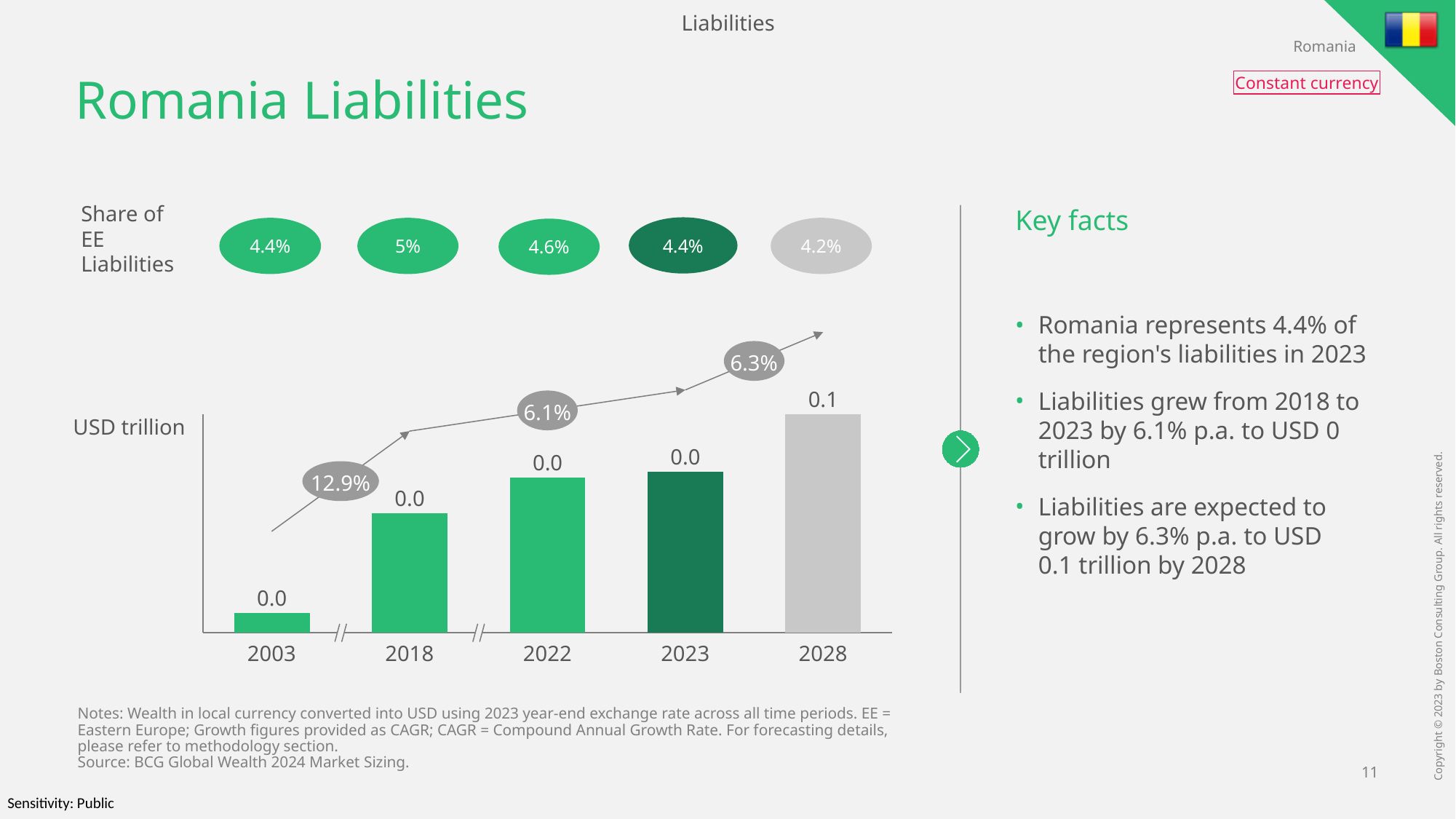
Which bar is taller, 2018 or 2022? 2022 How many years are shown on the x axis of the bar chart? 5 What is the data label on the bar for 2023? 0.0 Which year has the tallest bar in the chart? 2028 What growth rate (CAGR) is shown between 2023 and 2028? 6.3% Do the bar values rise or fall from 2003 to 2028? rise Which year has the shortest bar in the chart? 2003 What growth rate (CAGR) is shown between 2003 and 2018? 12.9% What type of chart is shown on the slide? bar chart What unit is given for the y axis of the bar chart? USD trillion What is the share of EE liabilities shown for 2018? 5% What is the data label on the bar for 2028? 0.1